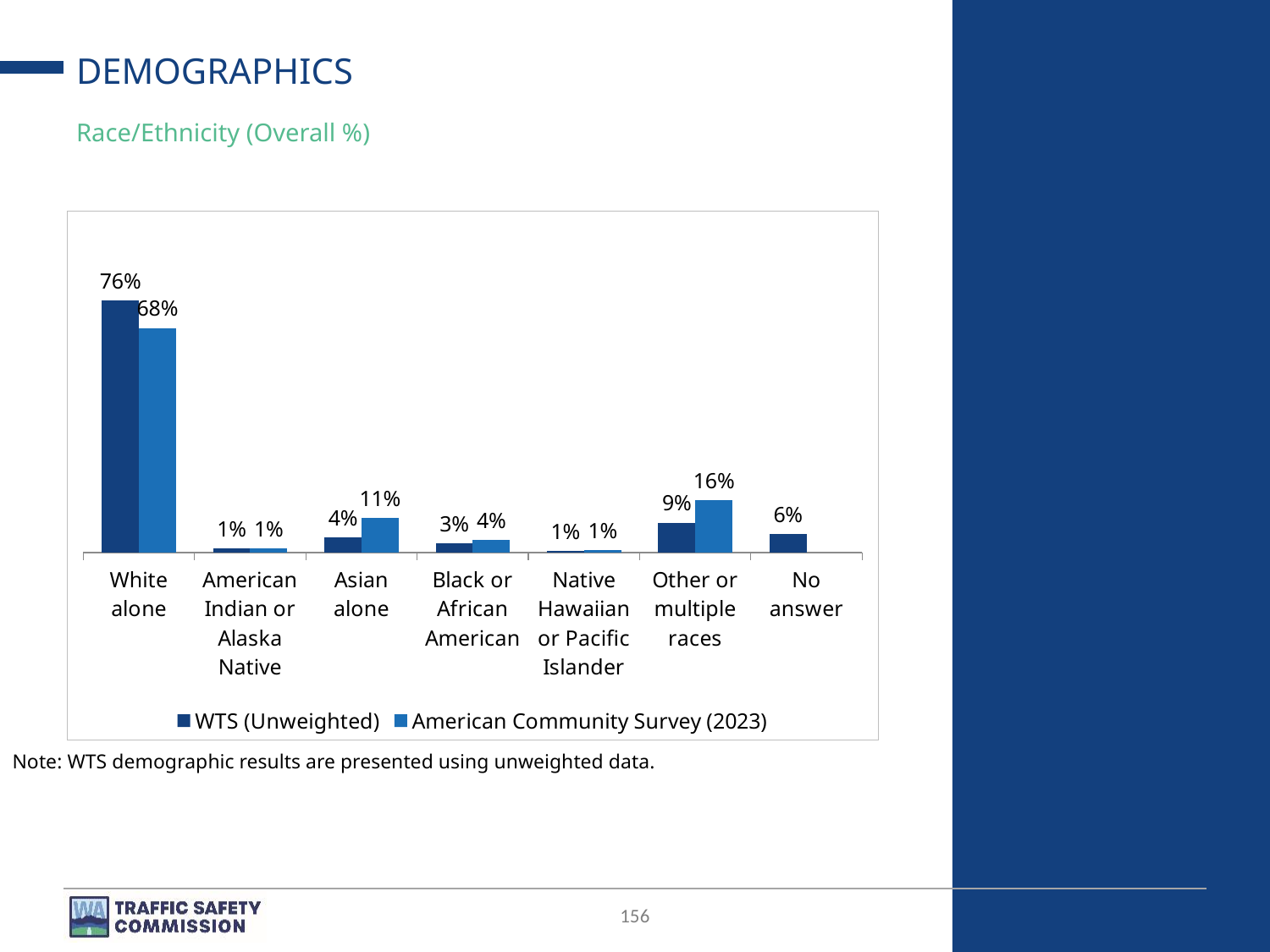
What is the American Community Survey (2023) value for Asian alone? 11% What is the difference between the American Community Survey (2023) and WTS (Unweighted) values for Other or multiple races? 7% Which category has the highest WTS (Unweighted) value? White alone What is the difference between the WTS (Unweighted) and American Community Survey (2023) values for White alone? 8% What is the WTS (Unweighted) value for No answer? 6% What kind of chart is shown on the slide? Bar chart What is the American Community Survey (2023) value for Other or multiple races? 16% How many series does the legend list? 2 How many race/ethnicity categories are shown on the x axis? 7 What is the WTS (Unweighted) value for White alone? 76% Which is larger for Asian alone: the WTS (Unweighted) value or the American Community Survey (2023) value? American Community Survey (2023) What is the subtitle of the chart? Race/Ethnicity (Overall %)